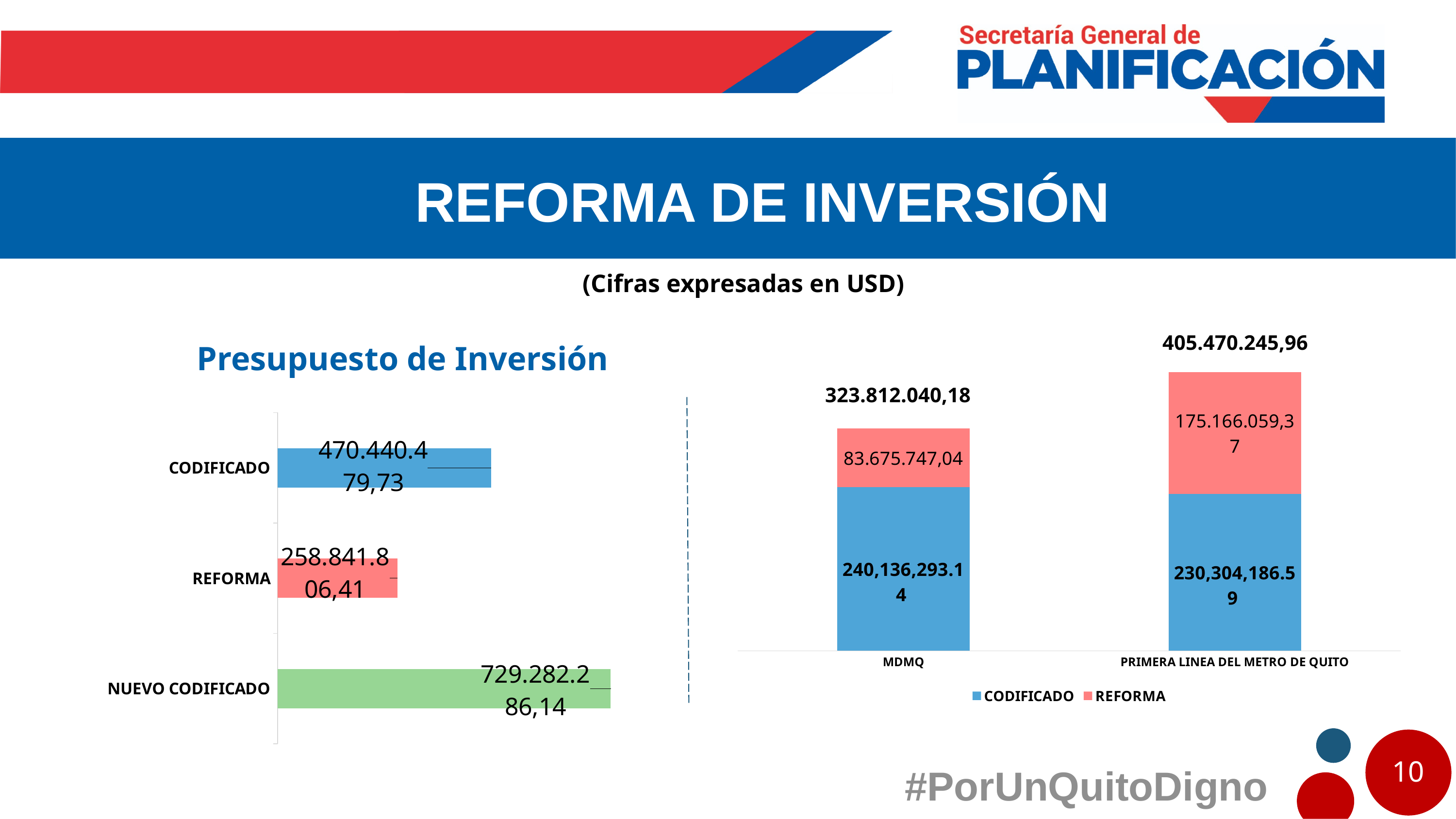
In the 'Presupuesto de Inversión' chart on the left, which category has the highest value? NUEVO CODIFICADO In the stacked bar chart on the right, which category has the larger REFORMA value, MDMQ or PRIMERA LINEA DEL METRO DE QUITO? PRIMERA LINEA DEL METRO DE QUITO In the 'Presupuesto de Inversión' chart on the left, what is the value for REFORMA? 258.841.806,41 How many series does the legend of the stacked bar chart on the right list? 2 In the 'Presupuesto de Inversión' chart on the left, what is the value for NUEVO CODIFICADO? 729.282.286,14 In the 'Presupuesto de Inversión' chart on the left, which category has the lowest value? REFORMA In the stacked bar chart on the right, what is the CODIFICADO value for MDMQ? 240,136,293.14 In the 'Presupuesto de Inversión' chart on the left, what is the value for CODIFICADO? 470.440.479,73 What kind of chart is the 'Presupuesto de Inversión' chart on the left? Bar chart In the stacked bar chart on the right, what is the REFORMA value for PRIMERA LINEA DEL METRO DE QUITO? 175.166.059,37 In the 'Presupuesto de Inversión' chart on the left, what is the difference between NUEVO CODIFICADO and CODIFICADO? 258.841.806,41 In the stacked bar chart on the right, what is the total of the MDMQ bar? 323.812.040,18